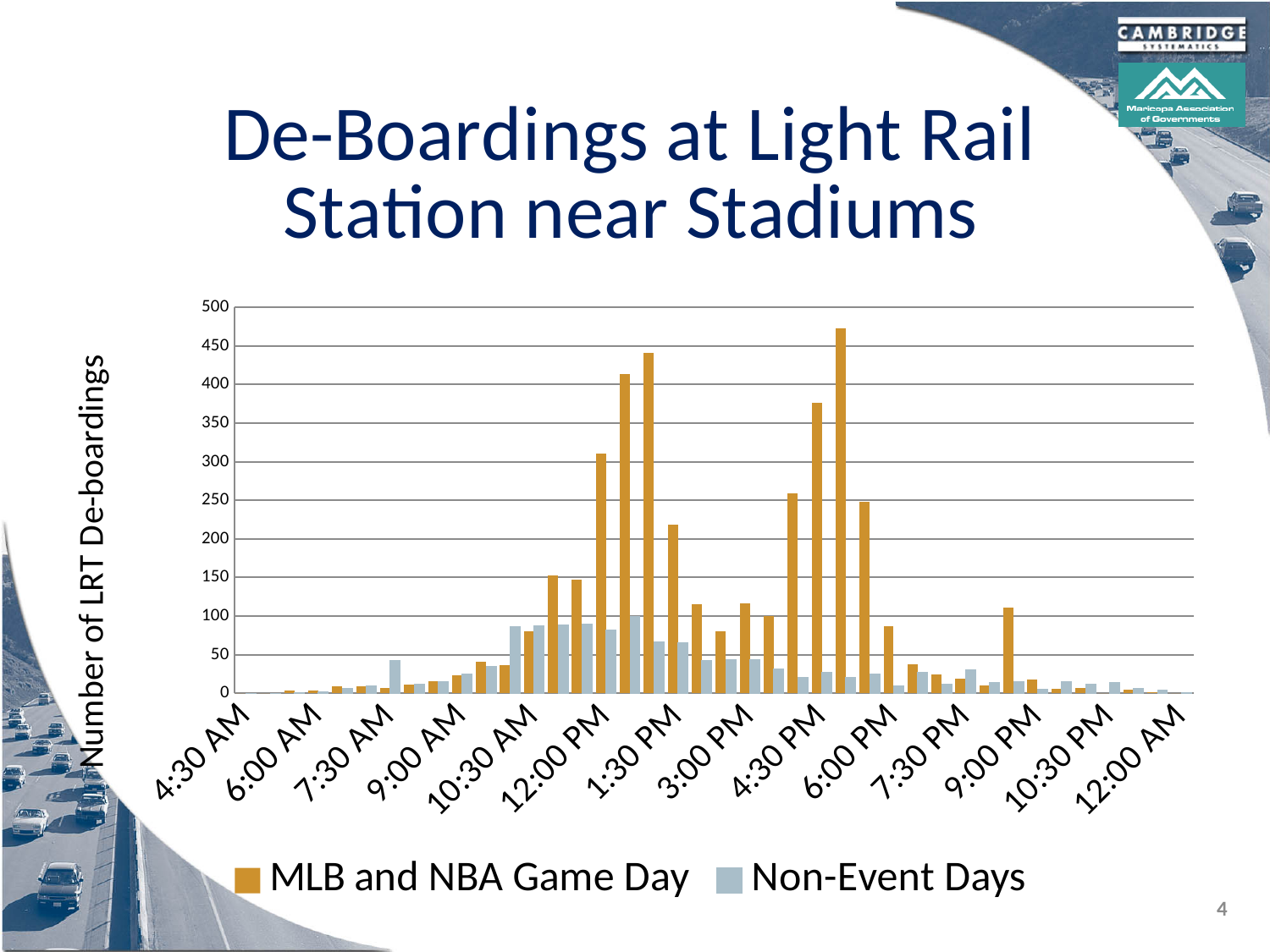
What is the maximum value shown on the vertical axis? 500 What is the title of the vertical axis? Number of LRT De-boardings Is the highest value for Non-Event Days greater or less than 150? less What kind of chart is shown on the slide? bar chart Which series reaches the higher peak value, MLB and NBA Game Day or Non-Event Days? MLB and NBA Game Day What are the two series named in the legend? MLB and NBA Game Day; Non-Event Days Is the value for MLB and NBA Game Day at 12:00 AM greater or less than 50? less Is the highest value for MLB and NBA Game Day greater or less than 450? greater How many series does the legend list? 2